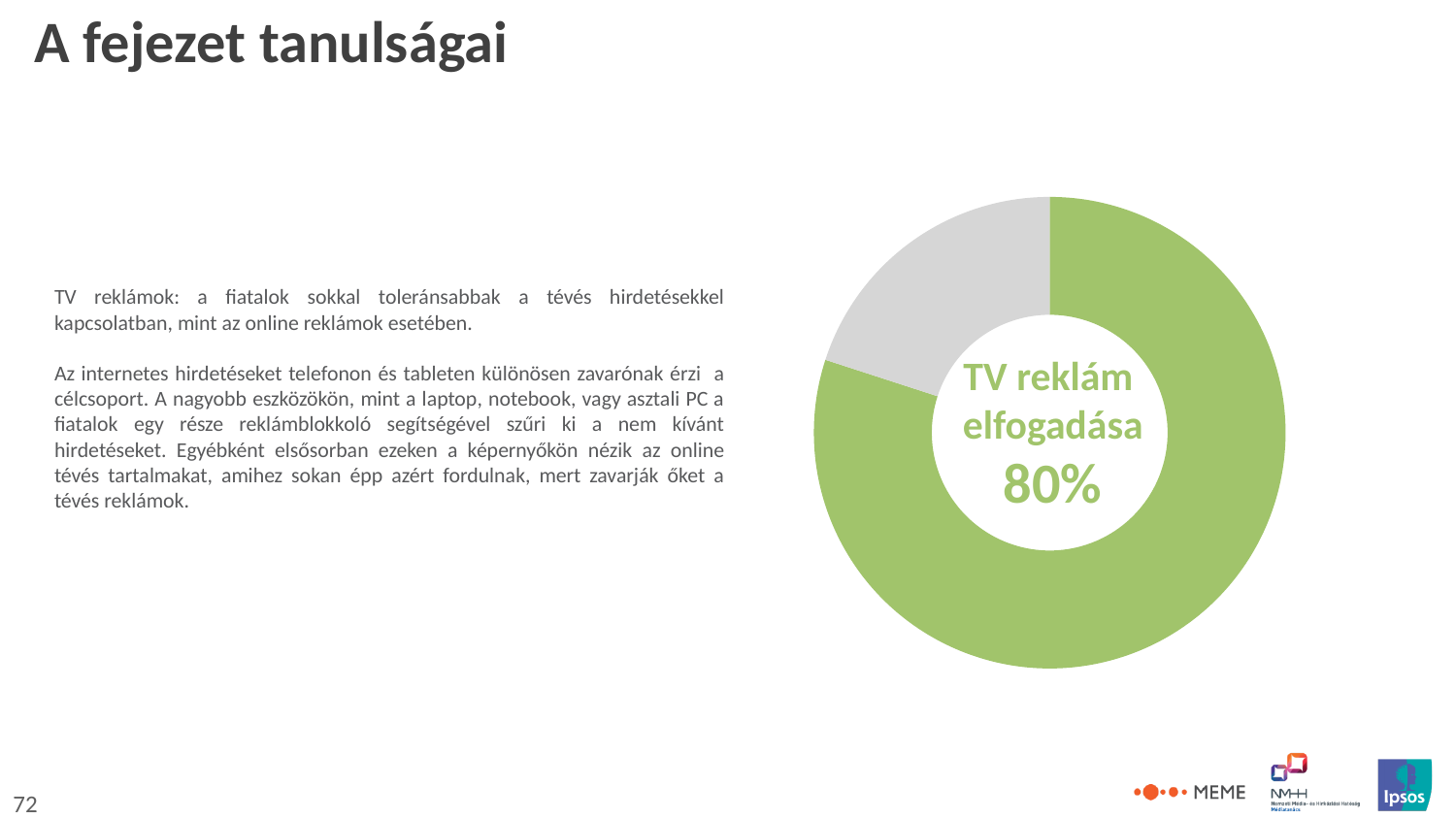
What colour is the larger slice of the donut chart? Green How many slices does the donut chart have? 2 What kind of chart is shown on the slide? Donut (pie) chart Which slice of the donut chart is larger, the green one or the grey one? The green one What label is written inside the donut chart? TV reklám elfogadása What share of the donut chart does the green slice represent? 80% What percentage is printed in the centre of the donut chart? 80% What is the value shown for TV reklám elfogadása? 80%